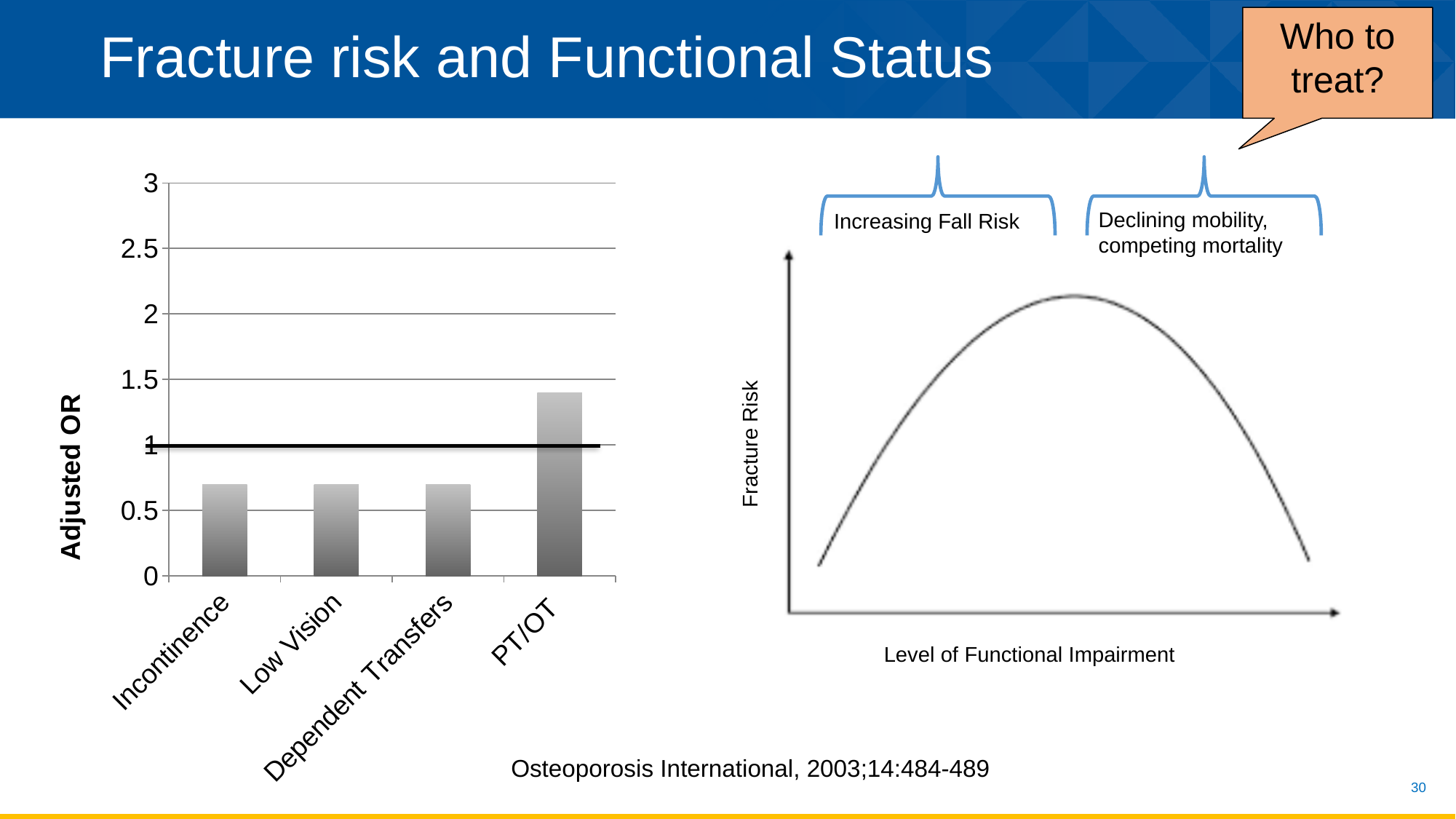
On the left bar chart, which is larger, the value for PT/OT or the value for Incontinence? PT/OT On the left bar chart, which category has the highest Adjusted OR? PT/OT On the right chart, does Fracture Risk rise, fall, or rise then fall as Level of Functional Impairment increases? rise then fall On the left bar chart, what kind of chart is it? bar chart On the left bar chart, is the value for Incontinence greater or less than 1? less On the left bar chart, is the value for Dependent Transfers greater or less than 1? less On the right chart, what is the label of the x axis? Level of Functional Impairment On the left bar chart, what is the title of the y axis? Adjusted OR On the left bar chart, how many categories are shown on the x axis? 4 On the left bar chart, is the value for PT/OT greater or less than 1.5? less